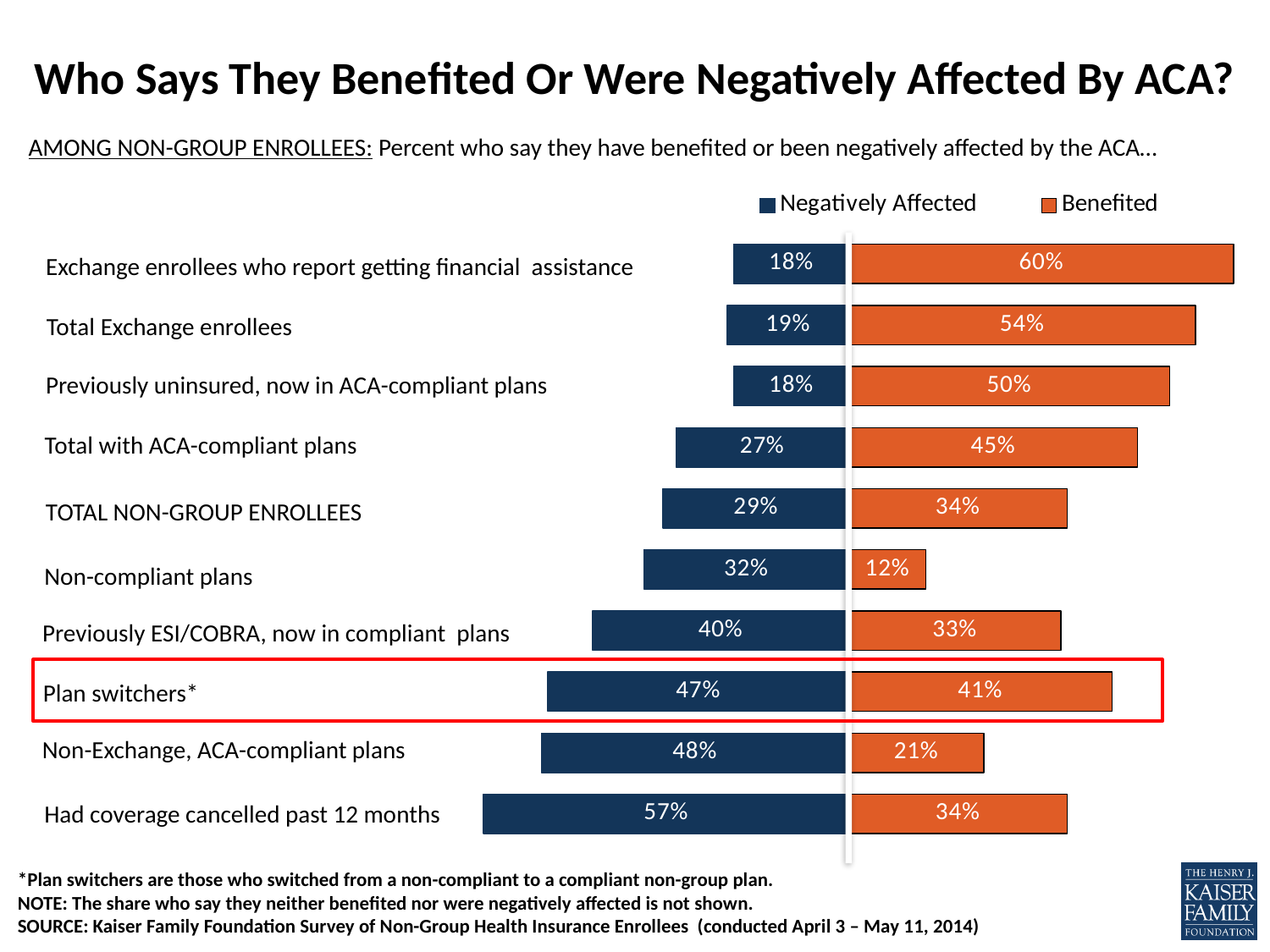
How many groups (categories) are shown in the chart? 10 Which group has the highest Benefited percentage? Exchange enrollees who report getting financial assistance What is the Benefited value for Non-compliant plans? 12% Which group has the lowest Benefited percentage? Non-compliant plans What percent of Total Exchange enrollees say they benefited from the ACA? 54% What percent of Plan switchers say they were negatively affected by the ACA? 47% Which series is shown in orange in the legend? Benefited Which group has the highest Negatively Affected percentage? Had coverage cancelled past 12 months What is the difference between the Benefited and Negatively Affected percentages for TOTAL NON-GROUP ENROLLEES? 5 percentage points How many series does the legend list? 2 What type of chart is shown on the slide? Bar chart For Non-Exchange, ACA-compliant plans, which is larger: the Negatively Affected share or the Benefited share? Negatively Affected